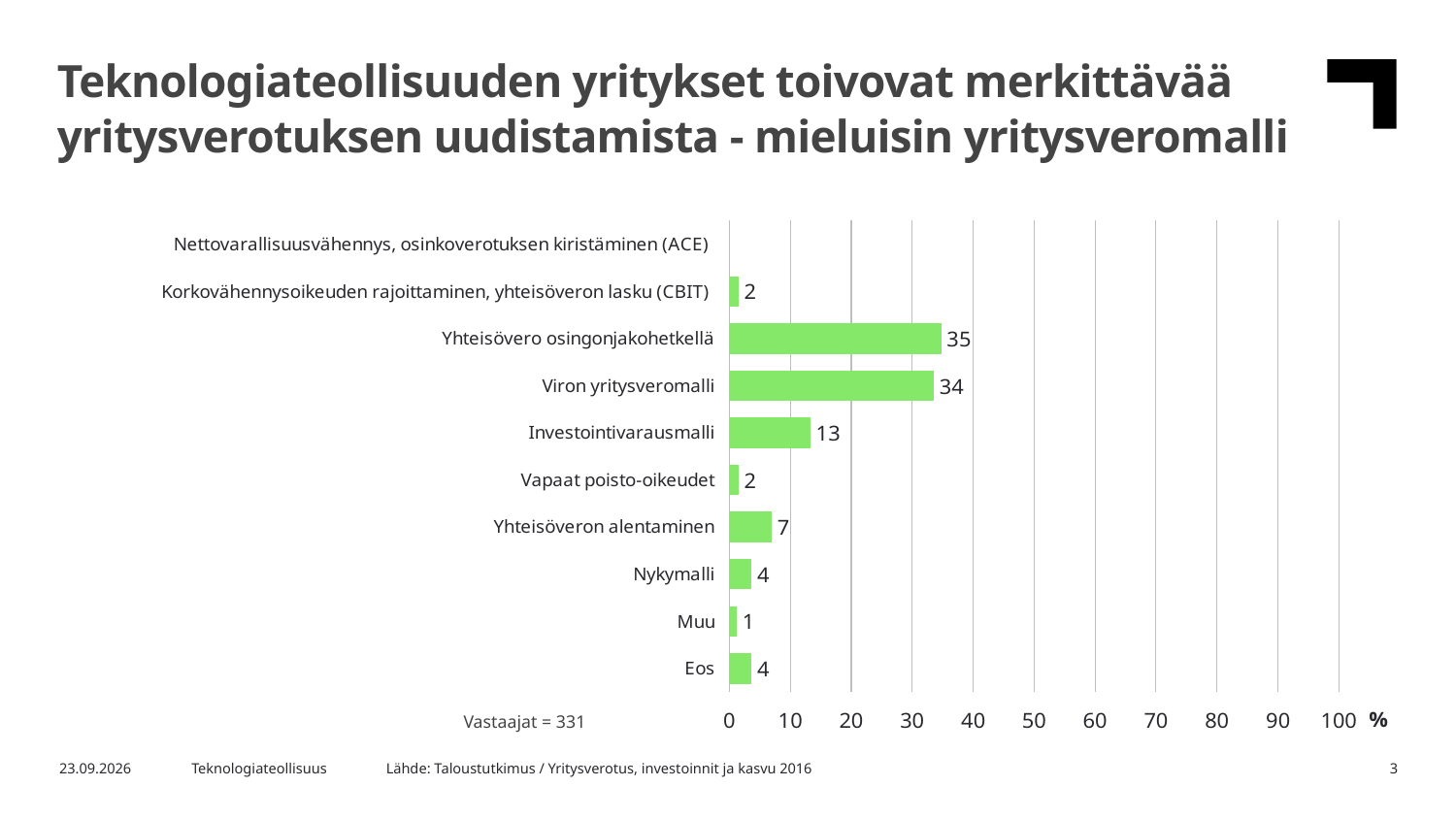
What value is shown for Nykymalli? 4 What is the number of respondents (Vastaajat) stated below the chart? 331 What value is shown for Muu? 1 Which is larger, the value for Nykymalli or the value for Muu? Nykymalli What value is shown for Investointivarausmalli? 13 How many categories are listed on the chart? 10 What value is shown for Viron yritysveromalli? 34 Which category has the highest value? Yhteisövero osingonjakohetkellä What value is shown for Yhteisöveron alentaminen? 7 What kind of chart is shown on the slide? Bar chart What is the difference between the values for Yhteisövero osingonjakohetkellä and Viron yritysveromalli? 1 What is the difference between the values for Investointivarausmalli and Yhteisöveron alentaminen? 6